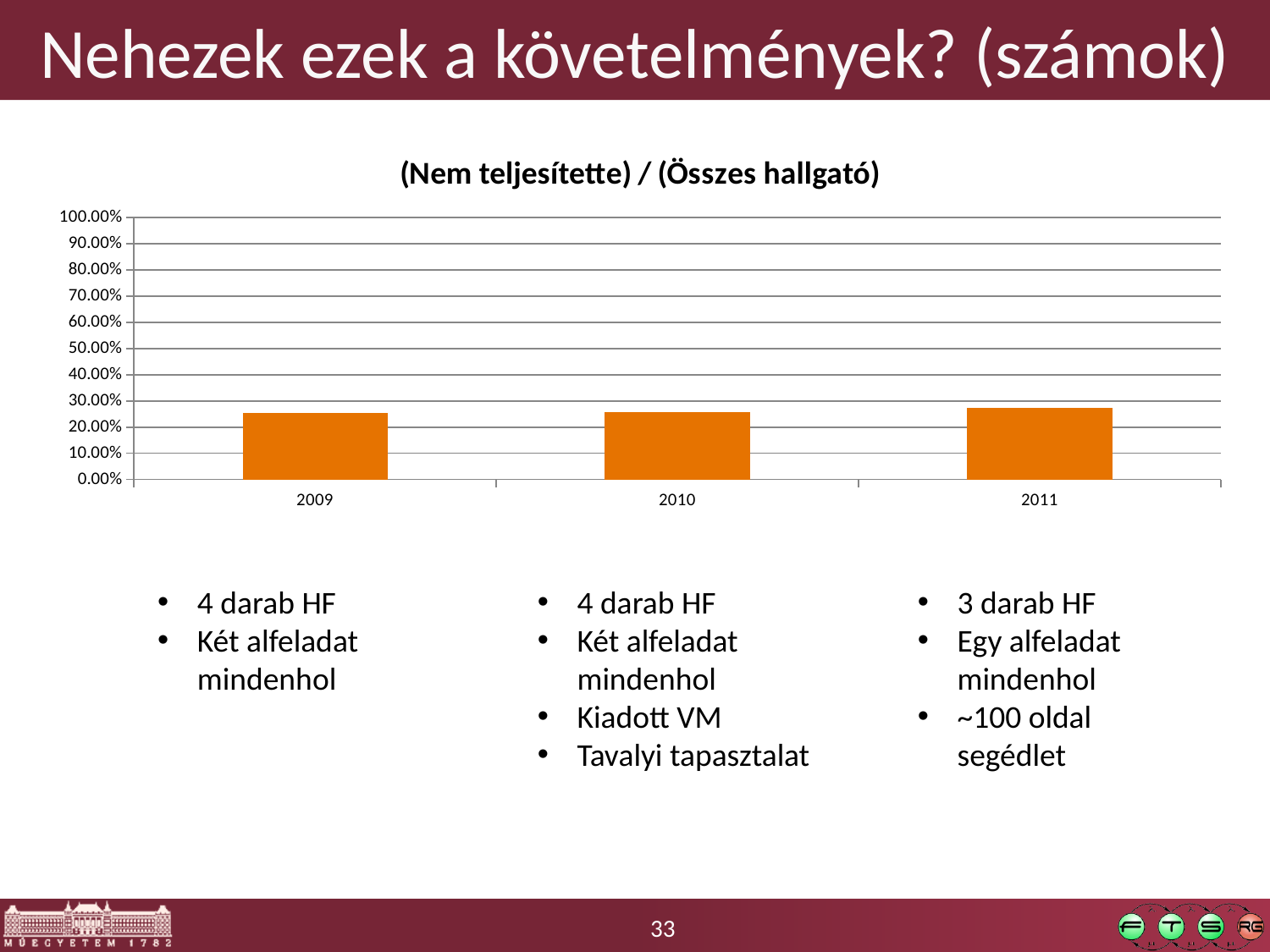
Is the value for 2011 greater or less than 20.00%? greater Is the value for 2009 greater or less than 30.00%? less Which year is the first category on the x axis of the chart? 2009 Is the value for 2010 greater or less than 30.00%? less What kind of chart is shown on the slide? bar chart How many categories (years) are shown on the x axis of the chart? 3 What is the highest value shown on the y axis of the chart? 100.00% What is the title of the chart? (Nem teljesítette) / (Összes hallgató)